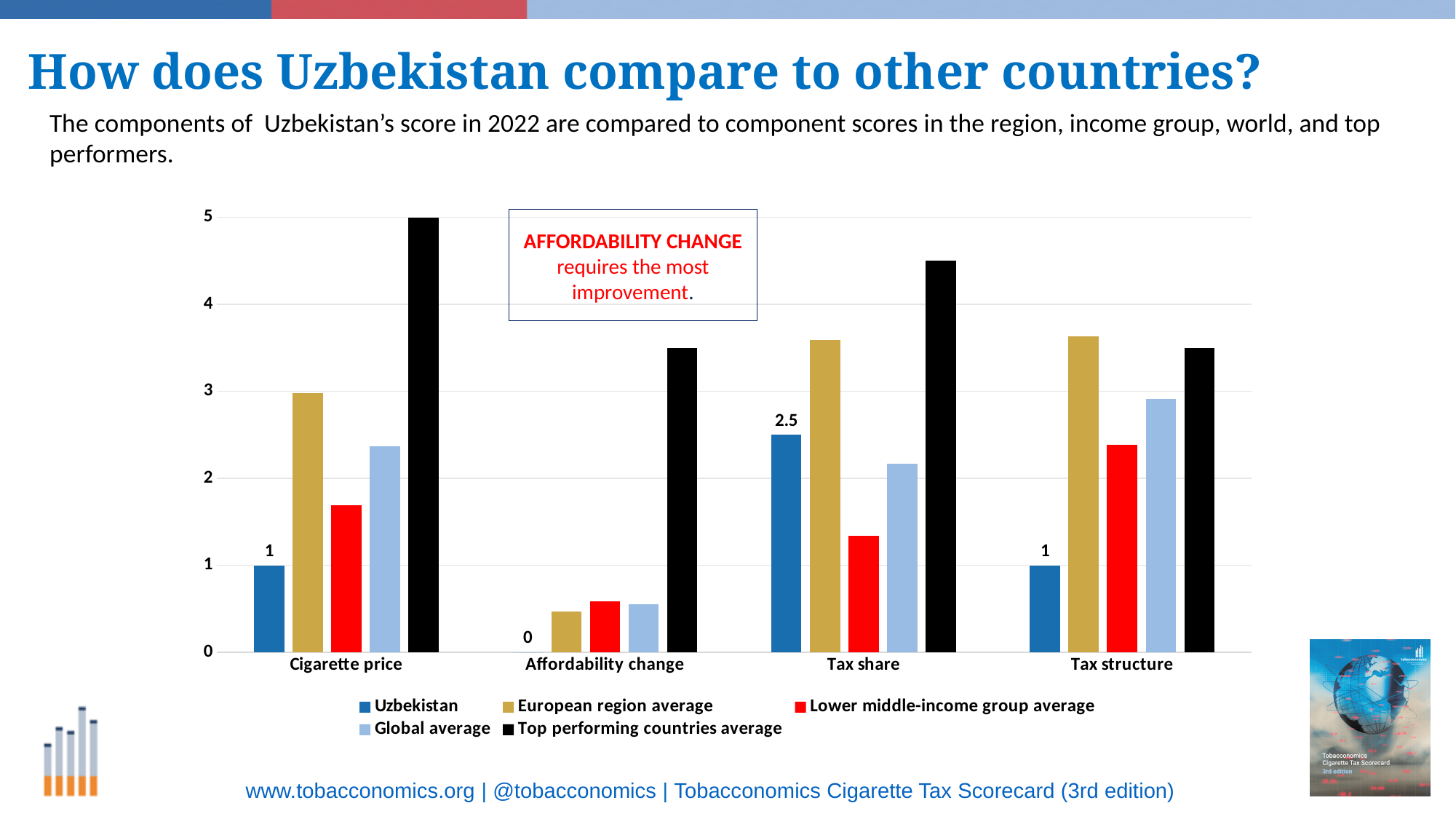
What is Uzbekistan's score for Cigarette price? 1 In which component does Uzbekistan have its lowest score? Affordability change Is the European region average for Tax share greater or less than 3? greater In which component does Uzbekistan have its highest score? Tax share What is Uzbekistan's score for Tax structure? 1 What kind of chart is shown on the slide? bar chart How many series does the legend list? 5 What is Uzbekistan's score for Tax share? 2.5 What is Uzbekistan's score for Affordability change? 0 For Cigarette price, which is larger: Uzbekistan or the Top performing countries average? Top performing countries average How many components (categories) are shown on the x axis? 4 What is the difference between Uzbekistan's Tax share score and its Cigarette price score? 1.5